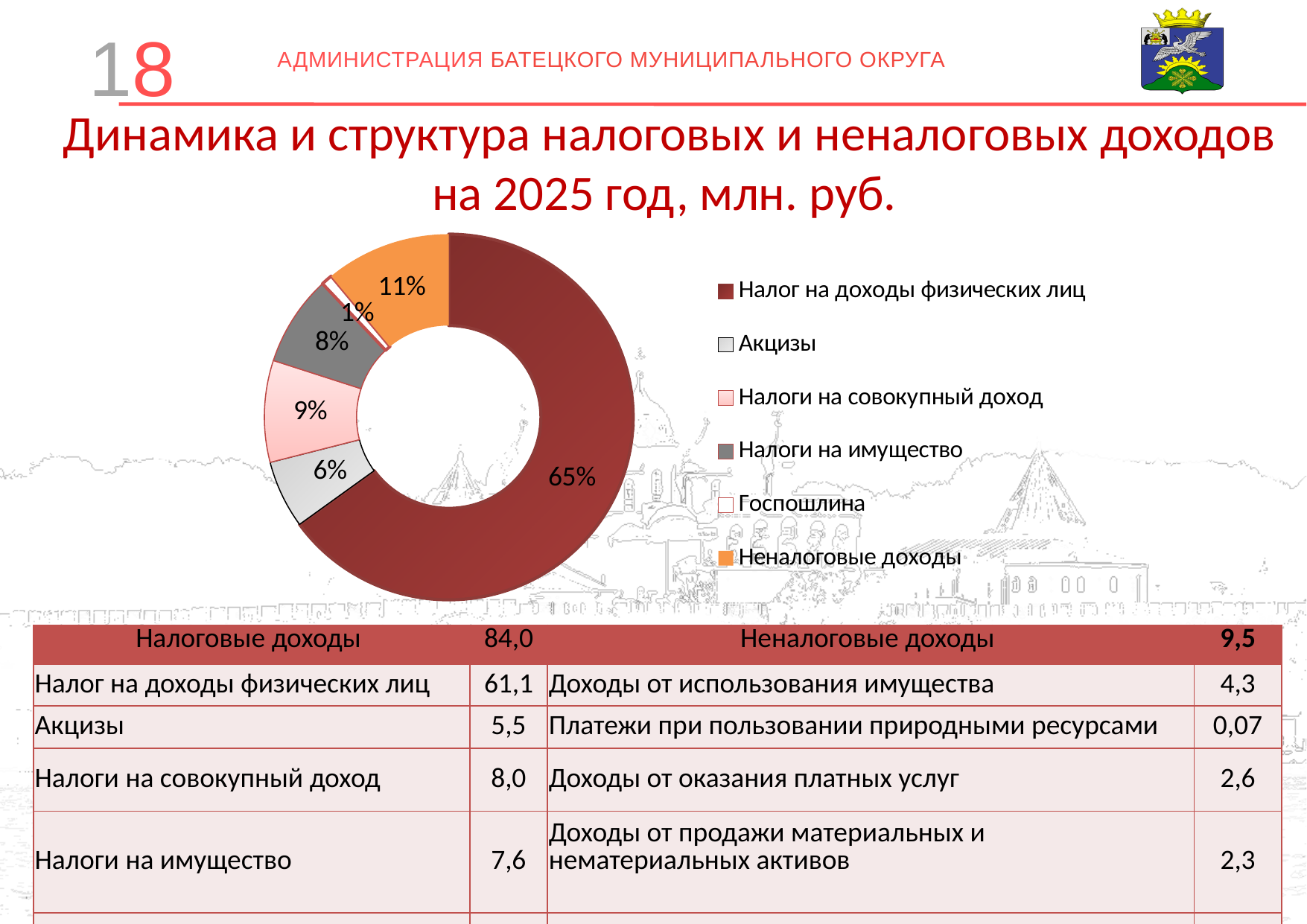
What type of chart is shown on the slide? Doughnut chart Which category has the smallest slice in the chart? Госпошлина What percentage is shown for Неналоговые доходы? 11% How many categories does the chart legend list? 6 What percentage is shown for the Акцизы slice? 6% What percentage is shown for Госпошлина? 1% What percentage is shown for Налоги на совокупный доход? 9% Which category has the largest slice in the chart? Налог на доходы физических лиц By how many percentage points does the Налог на доходы физических лиц slice exceed the Неналоговые доходы slice? 54 percentage points What share of the doughnut chart is labelled for Налог на доходы физических лиц? 65% Which slice is larger: Налоги на совокупный доход or Налоги на имущество? Налоги на совокупный доход What percentage is shown for Налоги на имущество? 8%